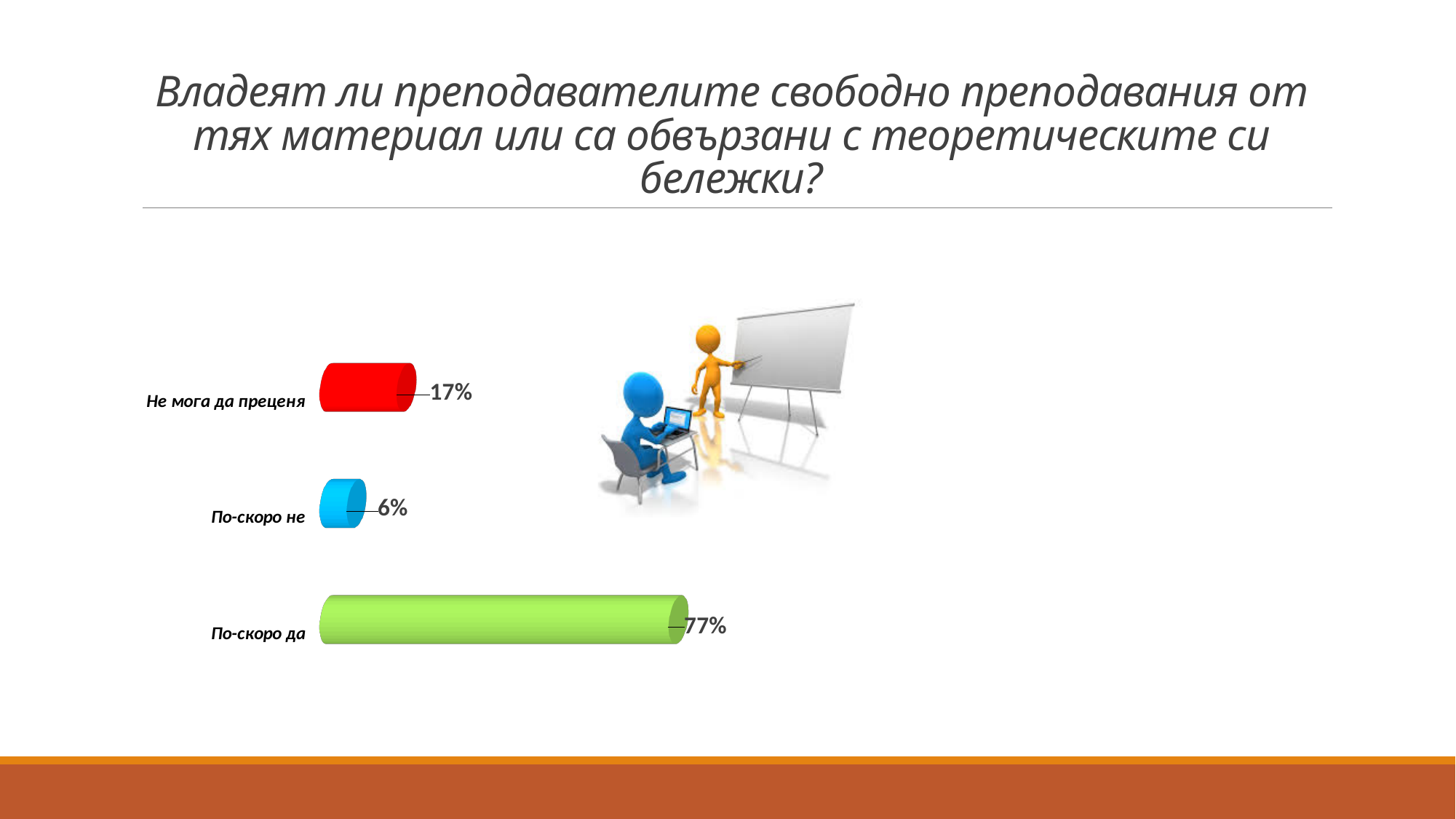
What colour is the bar for "По-скоро да"? Green How many categories are shown in the chart? 3 What is the value for "По-скоро не"? 6% Which category has the highest value? По-скоро да What is the difference between the values for "По-скоро да" and "Не мога да преценя"? 60% What is the value for "Не мога да преценя"? 17% What colour is the bar for "Не мога да преценя"? Red Which category has the lowest value? По-скоро не What is the difference between the values for "Не мога да преценя" and "По-скоро не"? 11% Which is larger, the value for "Не мога да преценя" or the value for "По-скоро не"? Не мога да преценя What is the value for "По-скоро да"? 77% What kind of chart is shown on the slide? Bar chart